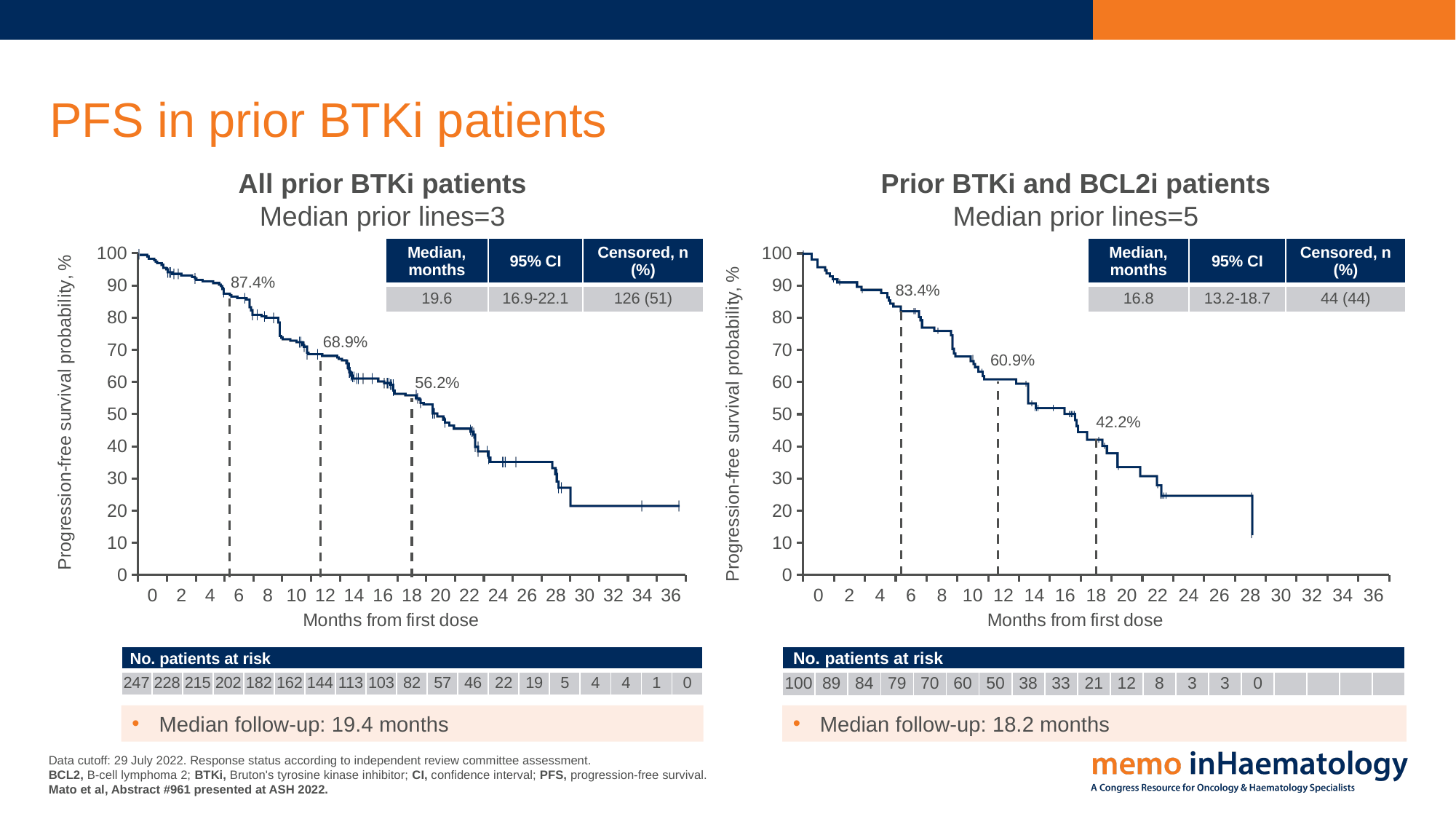
What is the x-axis label on the 'Prior BTKi and BCL2i patients' chart? Months from first dose What is the 95% CI shown in the table on the 'Prior BTKi and BCL2i patients' chart? 13.2-18.7 What is the difference between the 18-month PFS labels on the 'All prior BTKi patients' chart (56.2%) and the 'Prior BTKi and BCL2i patients' chart (42.2%)? 14.0% On the 'All prior BTKi patients' chart, what PFS probability is labelled at the first dashed line (about 6 months)? 87.4% Do the PFS curves on both charts rise or fall as months from first dose increase? fall On the 'All prior BTKi patients' chart, is the PFS probability at 30 months greater or less than 30? less On the 'All prior BTKi patients' chart, how many patients are at risk at the first time point (0 months)? 247 On the 'All prior BTKi patients' chart, what PFS probability is labelled at the third dashed line (about 18 months)? 56.2% Which chart shows the higher labelled PFS probability at about 12 months: 'All prior BTKi patients' or 'Prior BTKi and BCL2i patients'? All prior BTKi patients What is the median PFS in months shown in the table on the 'All prior BTKi patients' chart? 19.6 On the 'Prior BTKi and BCL2i patients' chart, what PFS probability is labelled at the second dashed line (about 12 months)? 60.9% On the 'Prior BTKi and BCL2i patients' chart, what PFS probability is labelled at the third dashed line (about 18 months)? 42.2%